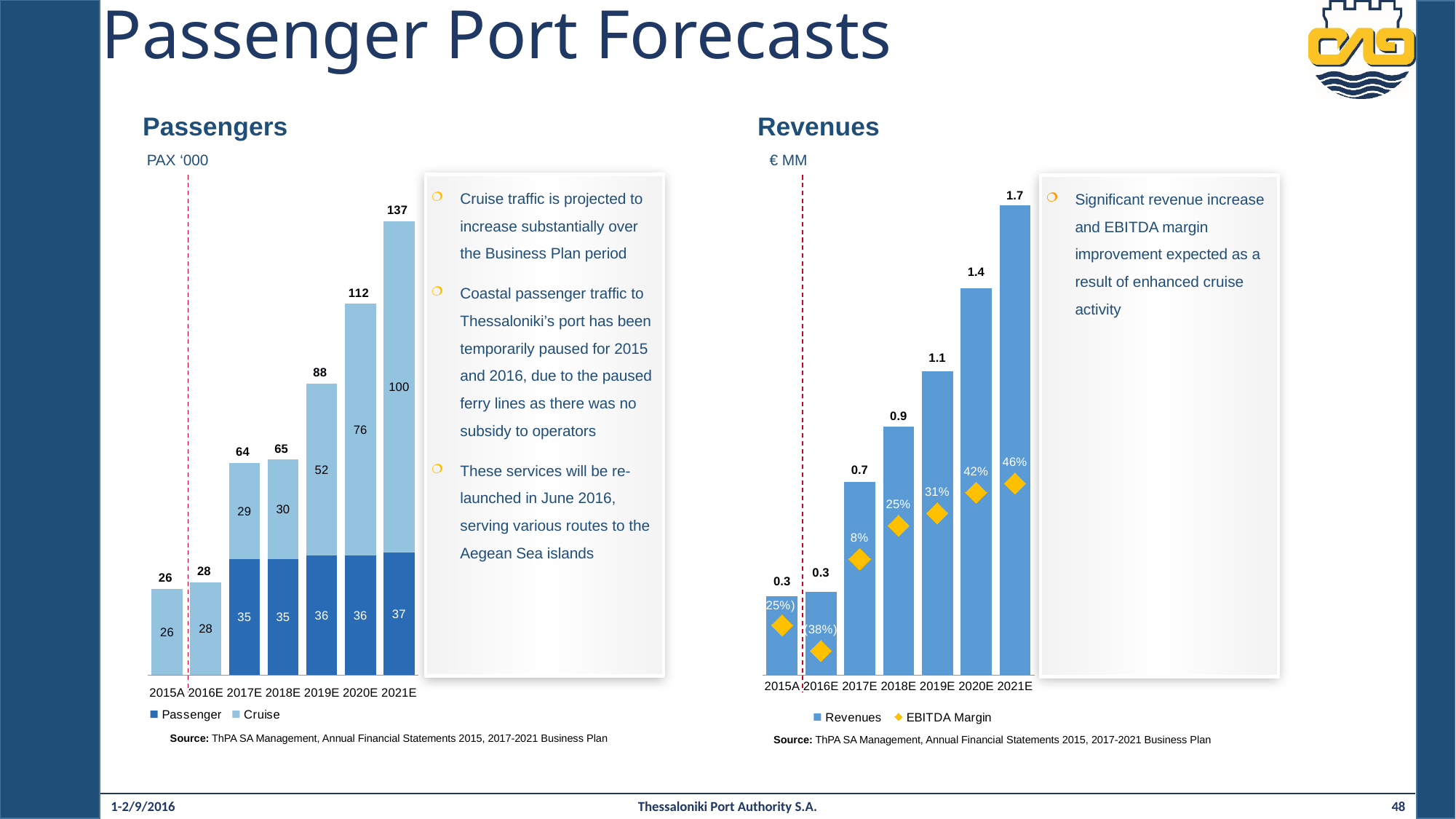
In the Passengers chart, which year has the highest total? 2021E In the Revenues chart, how many years are shown on the x axis? 7 In the Passengers chart, how many series does the legend list? 2 In the Passengers chart, what is the total of the stacked bar for 2020E? 112 In the Revenues chart, what is the EBITDA Margin for 2019E? 31% In the Revenues chart, what is the Revenues value for 2020E? 1.4 In the Passengers chart, what is the difference between the Cruise values for 2021E and 2020E? 24 In the Revenues chart, do the Revenues values rise or fall from 2016E to 2021E? rise In the Passengers chart, which year has the lowest total? 2015A In the Passengers chart, what is the Cruise value for 2021E? 100 In the Passengers chart, what is the Passenger value for 2019E? 36 In the Revenues chart, which year has the highest Revenues value? 2021E